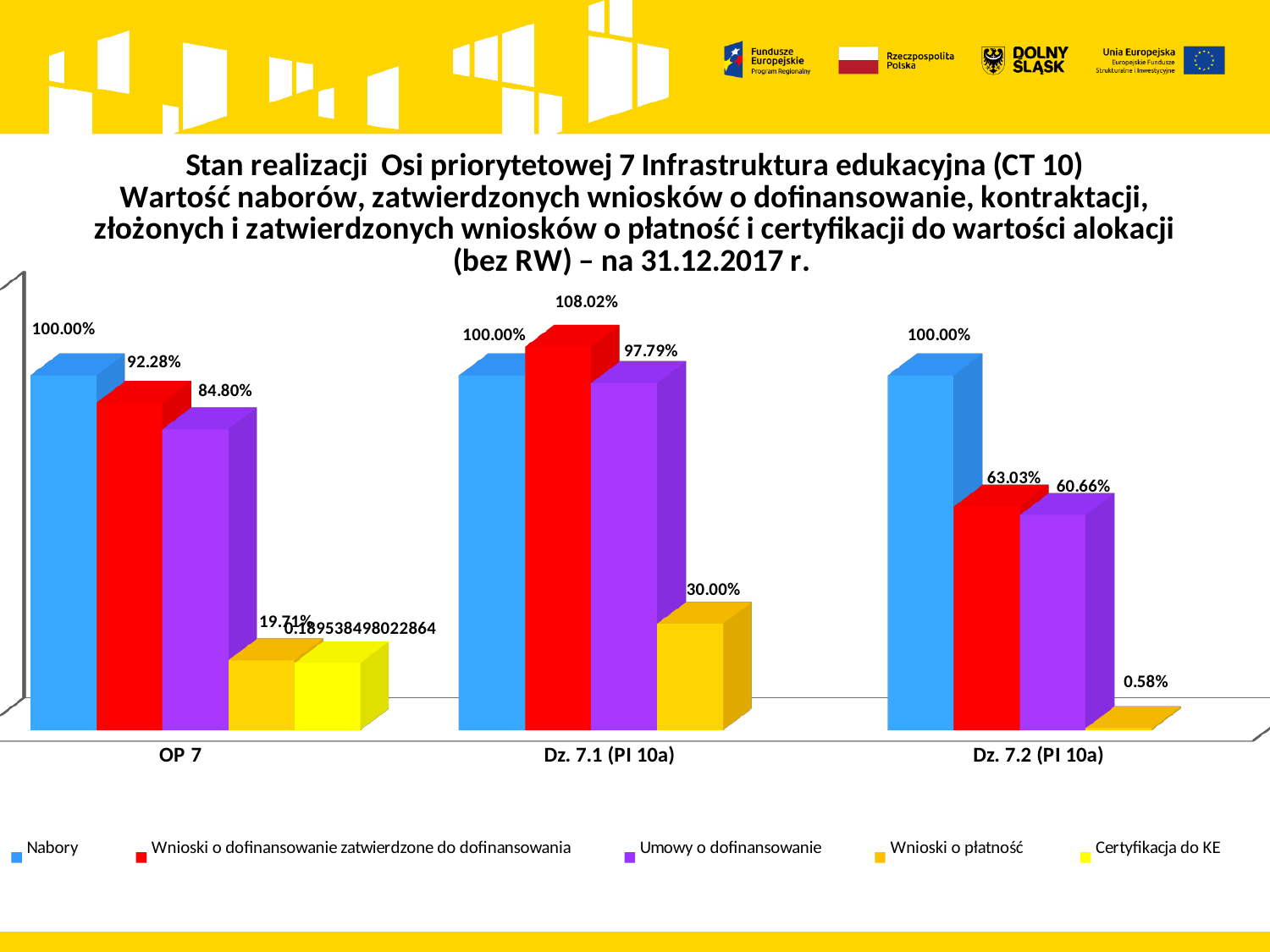
How many categories are shown on the x axis of the chart? 3 Which series is shown in purple in the legend? Umowy o dofinansowanie How many series does the legend list? 5 What is the difference between Wnioski o dofinansowanie zatwierdzone do dofinansowania and Umowy o dofinansowanie for Dz. 7.2 (PI 10a)? 2.37% Which category has the lowest value for Umowy o dofinansowanie? Dz. 7.2 (PI 10a) What type of chart is shown on the slide? bar chart What is the value of Wnioski o płatność for Dz. 7.1 (PI 10a)? 30.00% Which category has the highest value for Wnioski o dofinansowanie zatwierdzone do dofinansowania? Dz. 7.1 (PI 10a) What is the value of Umowy o dofinansowanie for OP 7? 84.80% Which is larger for OP 7: Wnioski o dofinansowanie zatwierdzone do dofinansowania or Umowy o dofinansowanie? Wnioski o dofinansowanie zatwierdzone do dofinansowania What is the value of Wnioski o płatność for Dz. 7.2 (PI 10a)? 0.58% What is the value of Wnioski o dofinansowanie zatwierdzone do dofinansowania for Dz. 7.1 (PI 10a)? 108.02%